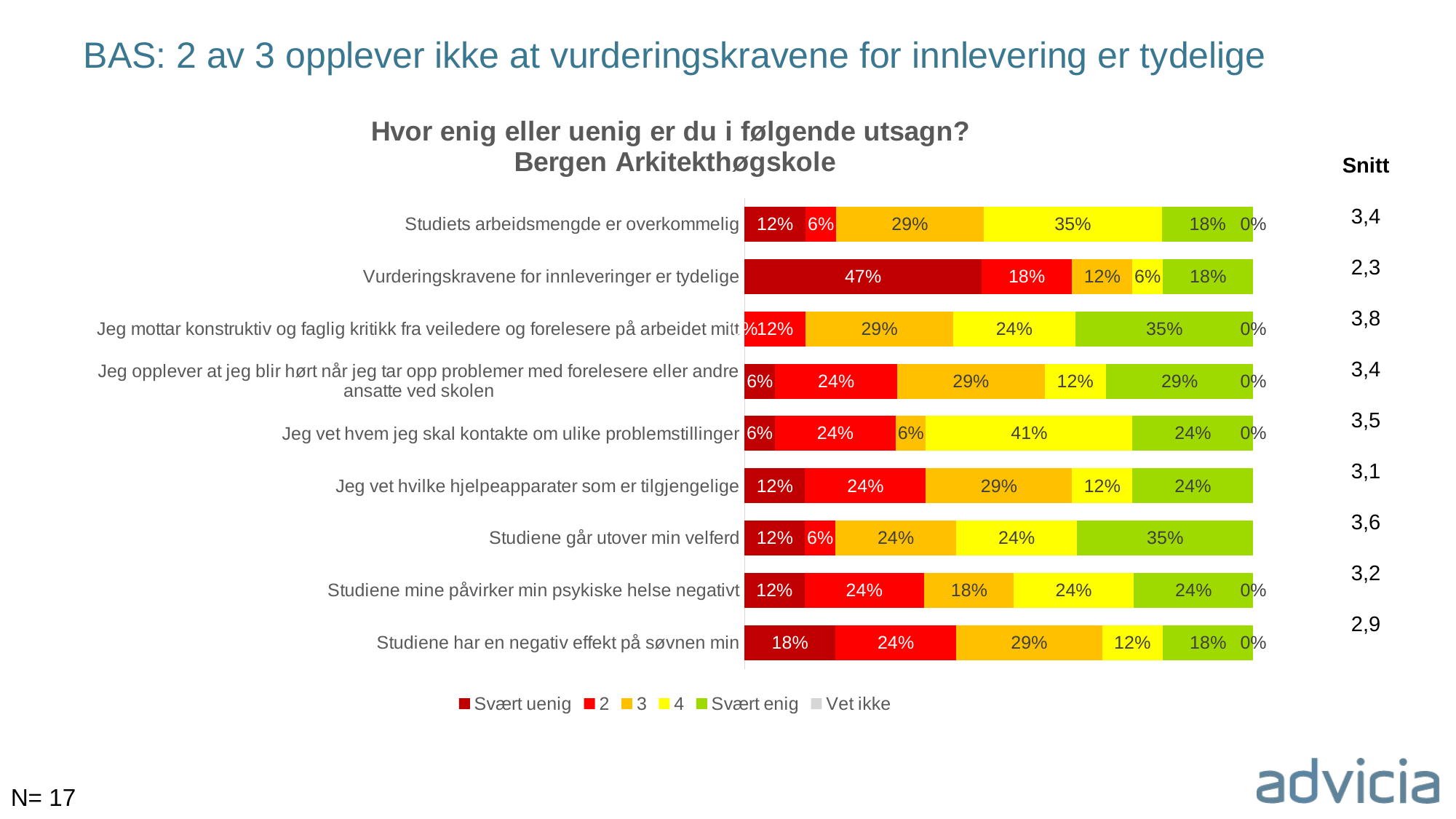
What is the title of the chart? Hvor enig eller uenig er du i følgende utsagn? Bergen Arkitekthøgskole What is the 'Svært uenig' share for 'Studiene har en negativ effekt på søvnen min'? 18% What is the 'Snitt' (average) value shown for 'Vurderingskravene for innleveringer er tydelige'? 2,3 What is the difference between the 'Svært uenig' share for 'Vurderingskravene for innleveringer er tydelige' and for 'Studiene har en negativ effekt på søvnen min'? 29% How many series does the legend list? 6 Which statement has the largest 'Svært uenig' share? Vurderingskravene for innleveringer er tydelige What is the '4' share for 'Jeg vet hvem jeg skal kontakte om ulike problemstillinger'? 41% What kind of chart is shown on the slide? Stacked bar chart What is the 'Svært enig' share for 'Studiene går utover min velferd'? 35% Which is larger: the '3' share for 'Studiets arbeidsmengde er overkommelig' or the '3' share for 'Studiene mine påvirker min psykiske helse negativt'? Studiets arbeidsmengde er overkommelig How many statements (categories) are plotted in the chart? 9 What is the 'Svært uenig' share for 'Vurderingskravene for innleveringer er tydelige'? 47%